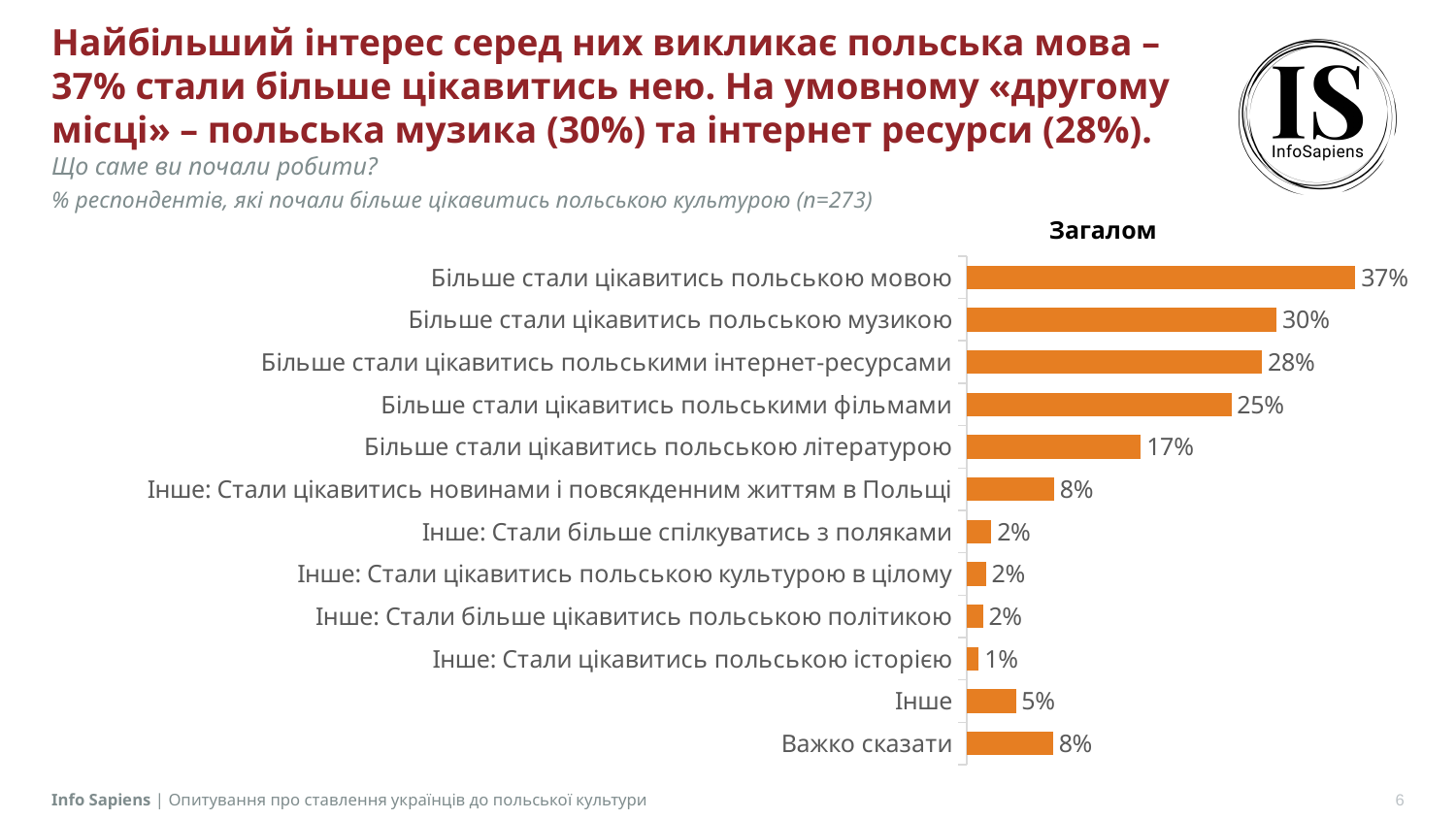
What is the value for 'Більше стали цікавитись польською літературою'? 17% What kind of chart is shown on the slide? Bar chart How many categories are shown in the chart? 12 Which category has the highest value in the chart? Більше стали цікавитись польською мовою What is the difference between the values for 'Більше стали цікавитись польською мовою' and 'Більше стали цікавитись польською музикою'? 7 percentage points What is the value for 'Інше'? 5% Which is larger: the value for 'Більше стали цікавитись польськими інтернет-ресурсами' or for 'Більше стали цікавитись польськими фільмами'? Більше стали цікавитись польськими інтернет-ресурсами Which category has the lowest value in the chart? Інше: Стали цікавитись польською історією What percentage of respondents said they became more interested in the Polish language (Більше стали цікавитись польською мовою)? 37% What is the title shown above the chart? Загалом What is the value for 'Більше стали цікавитись польськими фільмами'? 25% What is the value for 'Важко сказати'? 8%